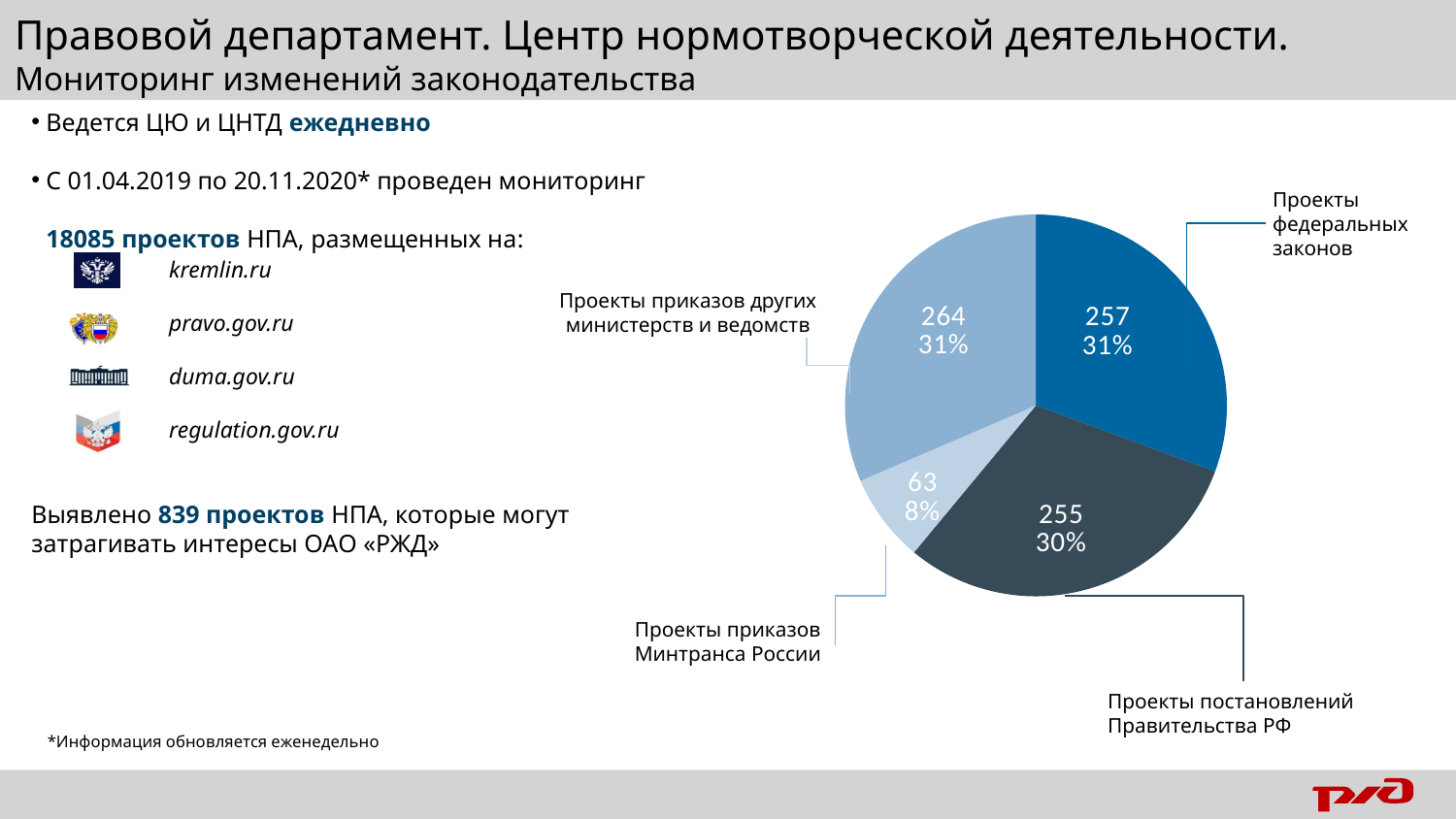
What is the difference between the values for 'Проекты приказов других министерств и ведомств' and 'Проекты приказов Минтранса России'? 201 How many projects are shown for 'Проекты федеральных законов'? 257 What is the difference between the values for 'Проекты федеральных законов' and 'Проекты постановлений Правительства РФ'? 2 Which category has the smallest slice in the pie chart? Проекты приказов Минтранса России What percentage is shown for 'Проекты приказов других министерств и ведомств'? 31% How many slices does the pie chart have? 4 What is the total of all four values in the pie chart? 839 Which is larger: the value for 'Проекты приказов других министерств и ведомств' or for 'Проекты приказов Минтранса России'? Проекты приказов других министерств и ведомств What kind of chart is shown on the slide? pie chart What value is shown for 'Проекты приказов Минтранса России'? 63 Which category has the largest value in the pie chart? Проекты приказов других министерств и ведомств What share of the pie does 'Проекты постановлений Правительства РФ' take? 30%